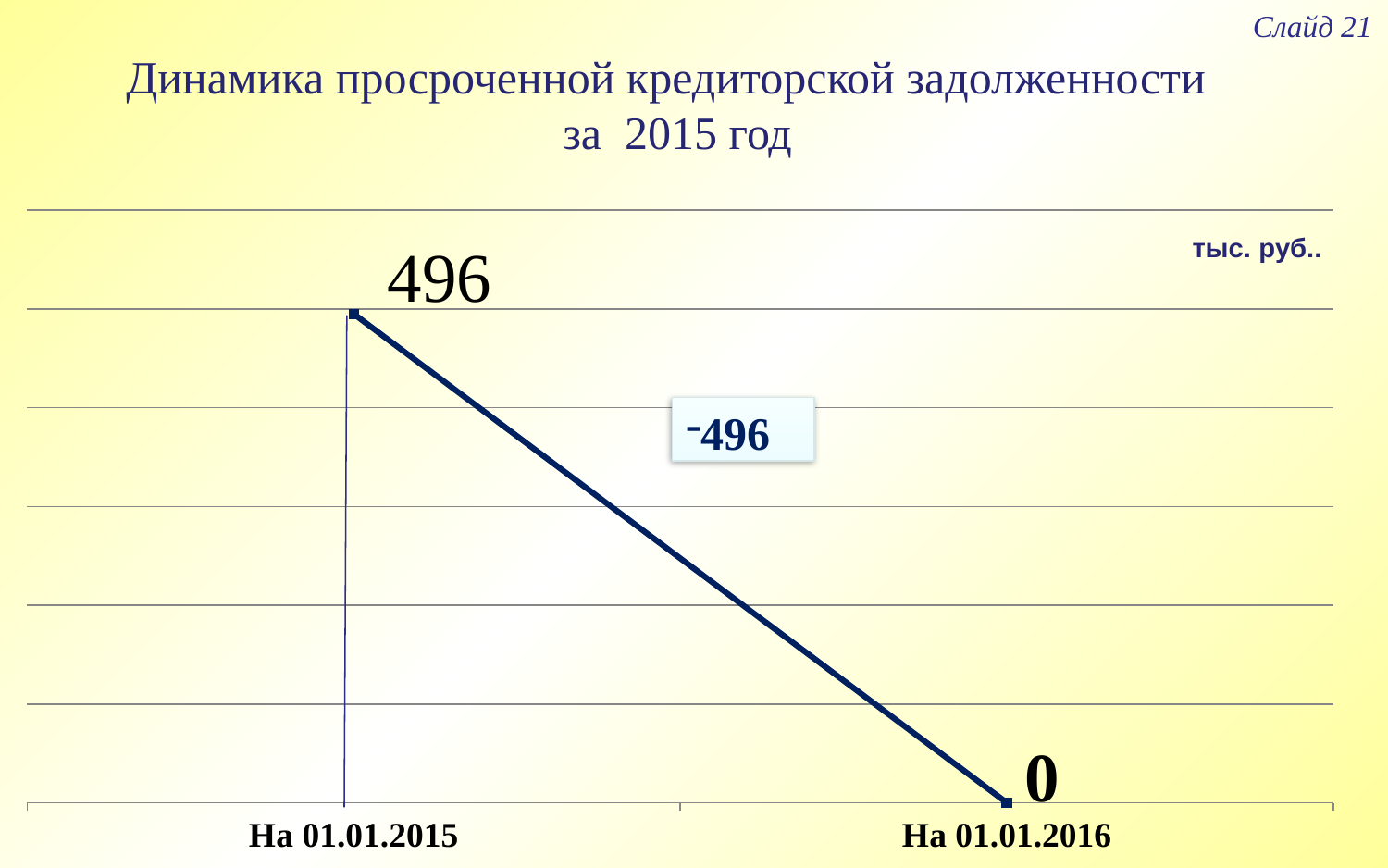
What unit is indicated for the chart values? тыс. руб. How many data points are plotted on the chart? 2 Which is larger, the value for На 01.01.2015 or the value for На 01.01.2016? На 01.01.2015 What is the difference between the value for На 01.01.2015 and the value for На 01.01.2016? 496 Which date has the lowest value? На 01.01.2016 What is the value for На 01.01.2016? 0 Which date has the highest value? На 01.01.2015 What change is shown in the callout box on the chart? -496 Do the values rise or fall from На 01.01.2015 to На 01.01.2016? fall What is the value for На 01.01.2015? 496 What kind of chart is shown on the slide? line chart